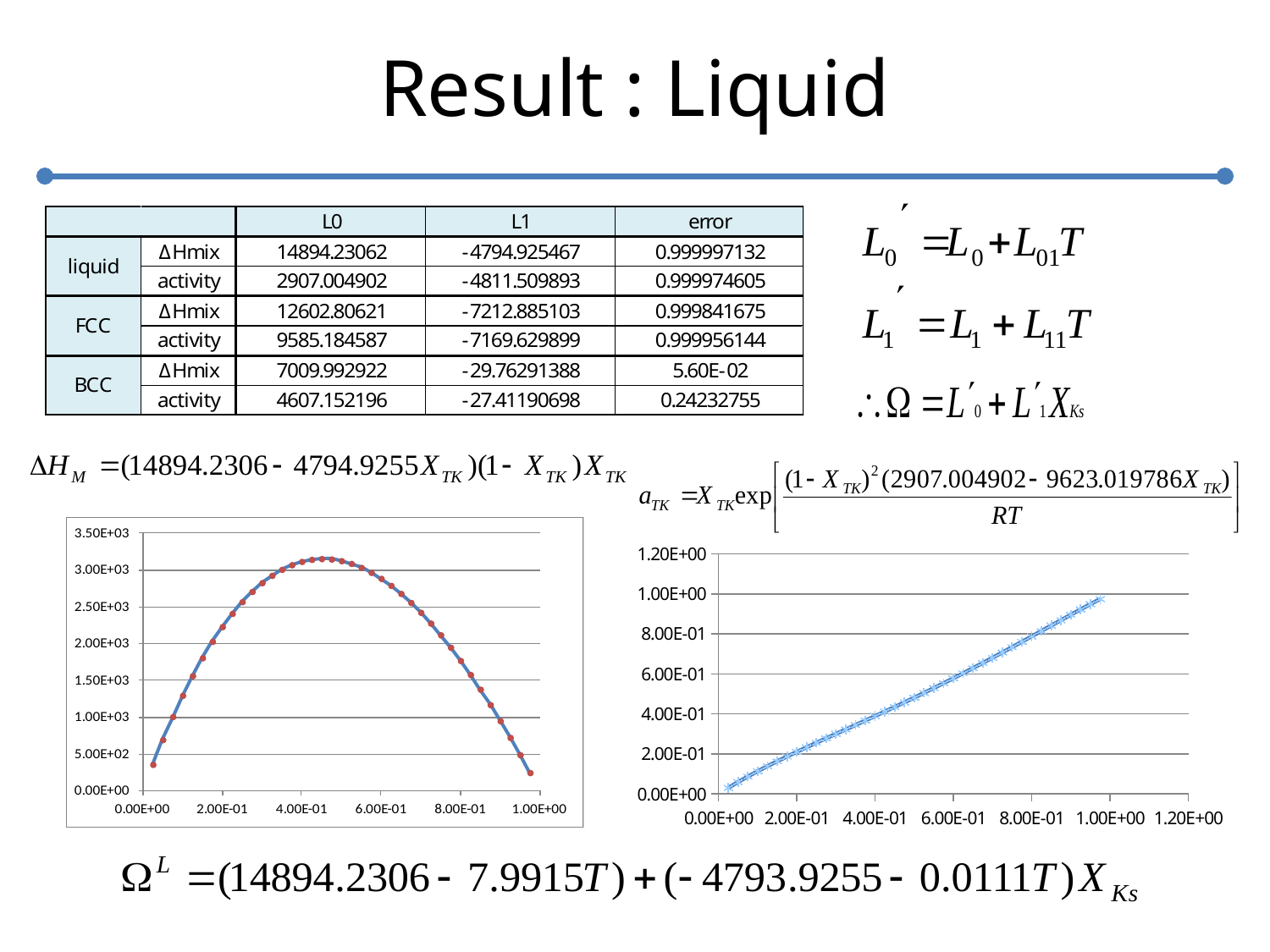
What is the highest tick label on the x axis of the chart on the right? 1.20E+00 In the chart on the right, is the value at x = 5.00E-01 greater or less than 4.00E-01? greater In the chart on the left, how do the plotted values change as the x value increases from 0.00E+00 to 1.00E+00? rise then fall What kind of chart is the chart on the right of the slide? scatter chart In the chart on the right, do the plotted values rise or fall as the x value increases? rise What is the highest tick label on the y axis of the chart on the left? 3.50E+03 What kind of chart is the chart on the left of the slide? scatter chart with a fitted line In the chart on the left, is the peak value of the curve greater or less than 3.00E+03? greater In the chart on the left, is the value at x = 6.00E-01 greater or less than 2.50E+03? greater